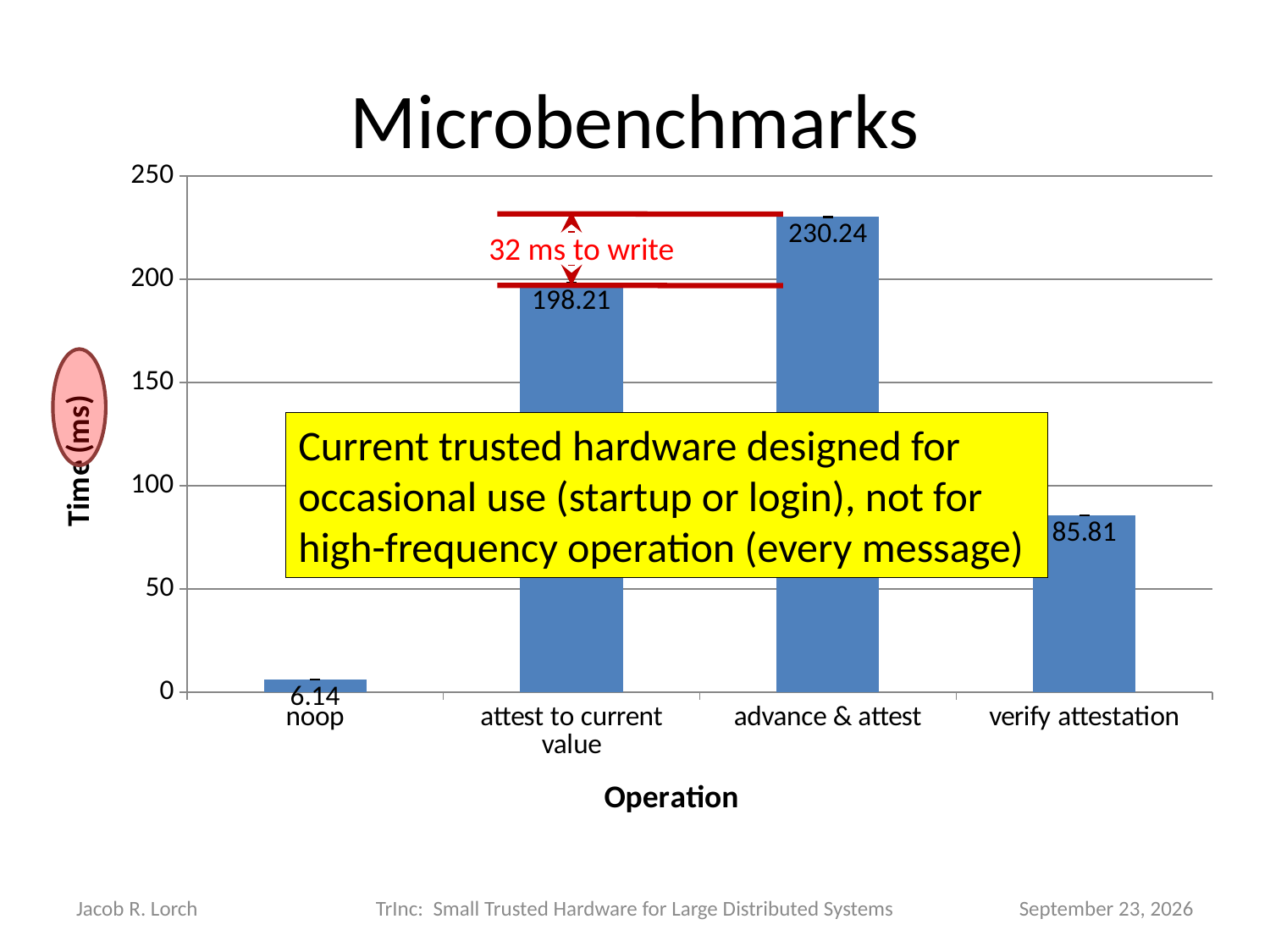
Which operation has the lowest time? noop How many operations are shown on the x axis? 4 What is the time in ms for the attest to current value operation? 198.21 Which operation has the highest time? advance & attest What is the time in ms for the advance & attest operation? 230.24 What is the difference in ms between attest to current value and verify attestation? 112.4 What is the time in ms for the verify attestation operation? 85.81 Which takes longer, verify attestation or attest to current value? attest to current value What is the time in ms for the noop operation? 6.14 Is the value for verify attestation greater or less than 100? less What type of chart is shown on the slide? bar chart What is the difference in ms between advance & attest and attest to current value? 32.03